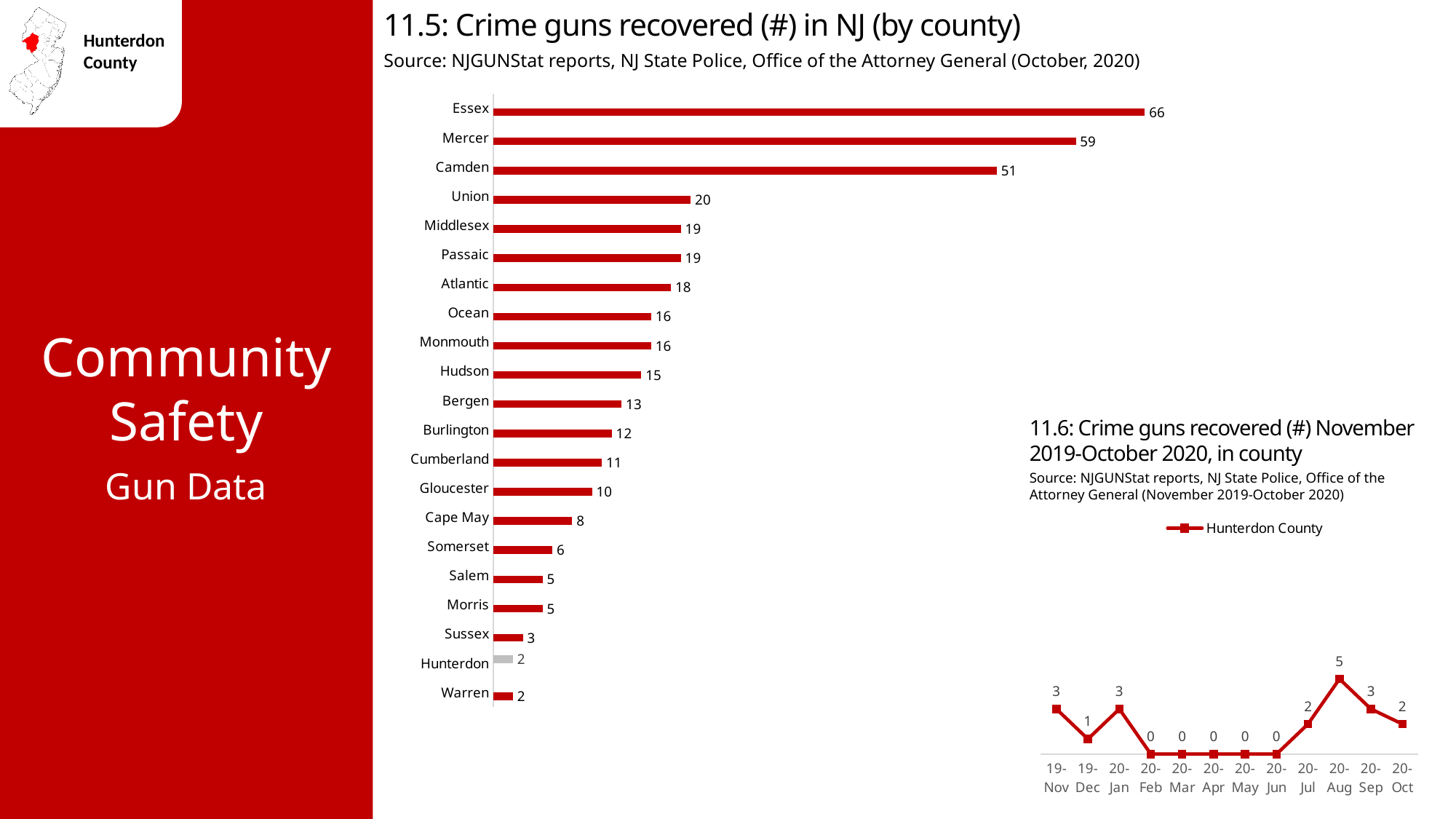
In the chart '11.5: Crime guns recovered (#) in NJ (by county)', what is the value for Essex? 66 In the chart '11.6: Crime guns recovered (#) November 2019-October 2020, in county', which month has the highest value? 20-Aug In the chart '11.6: Crime guns recovered (#) November 2019-October 2020, in county', what is the value for 19-Dec? 1 In the chart '11.5: Crime guns recovered (#) in NJ (by county)', which is larger, Union or Atlantic? Union In the chart '11.6: Crime guns recovered (#) November 2019-October 2020, in county', what is the value for 20-Aug? 5 What kind of chart is '11.5: Crime guns recovered (#) in NJ (by county)'? Bar chart How many series does the legend list in the chart '11.6: Crime guns recovered (#) November 2019-October 2020, in county'? 1 What kind of chart is '11.6: Crime guns recovered (#) November 2019-October 2020, in county'? Line chart In the chart '11.5: Crime guns recovered (#) in NJ (by county)', what is the value for Hunterdon? 2 In the chart '11.5: Crime guns recovered (#) in NJ (by county)', which county has the highest value? Essex How many counties are shown in the chart '11.5: Crime guns recovered (#) in NJ (by county)'? 21 In the chart '11.5: Crime guns recovered (#) in NJ (by county)', what is the difference between Mercer and Camden? 8